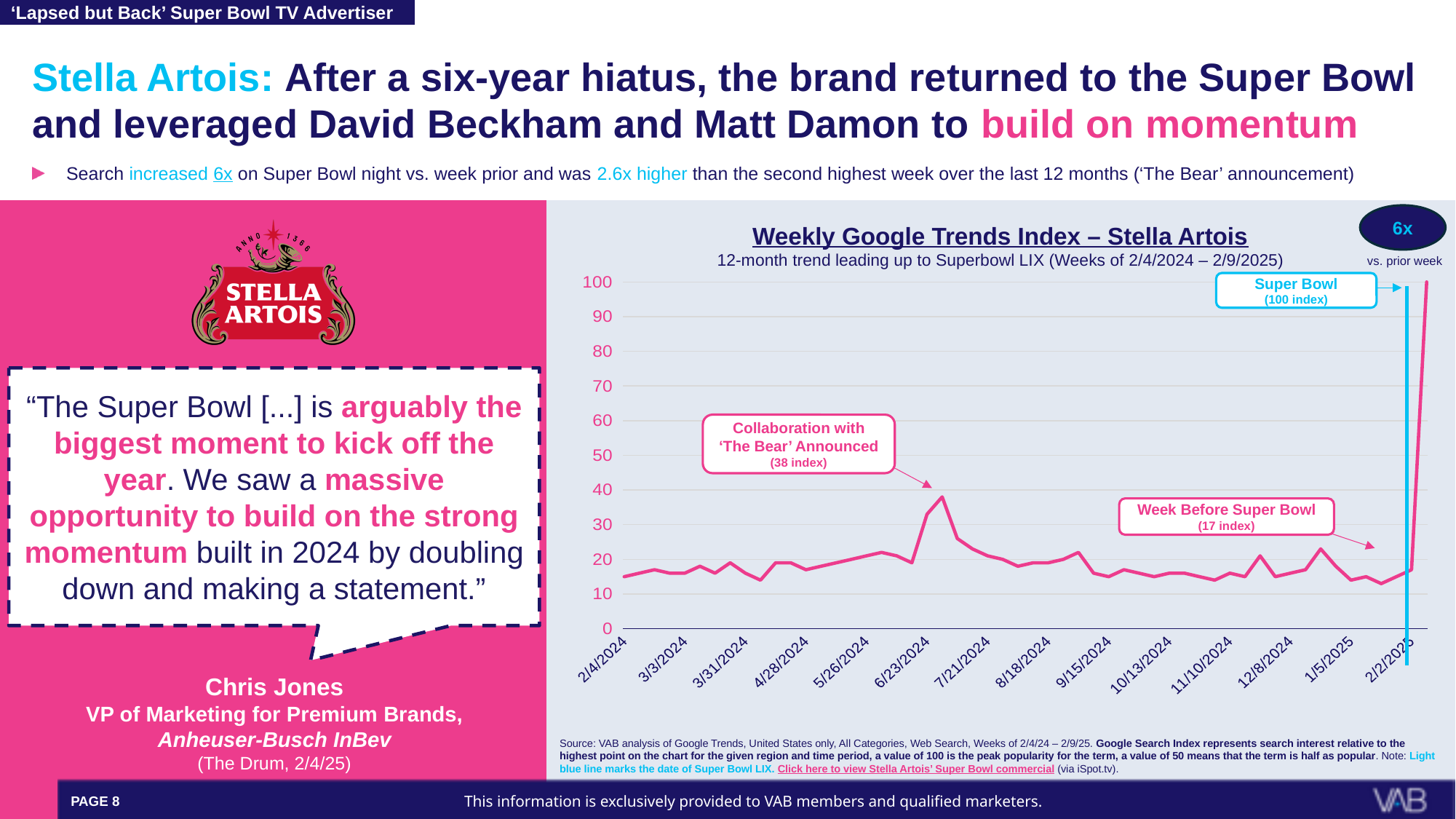
Which labeled event has the highest index value on the chart? Super Bowl Is the index value for the week of 10/13/2024 greater or less than 30? less Is the index value for the week of 2/4/2024 greater or less than 20? less What is the Google Trends index value for the Super Bowl week? 100 Which is larger: the index for the 'The Bear' announcement week or the index for the week before the Super Bowl? 'The Bear' announcement week How much higher is the Super Bowl index (100) than the 'The Bear' announcement index (38)? 62 What index value is labeled for the week when the collaboration with 'The Bear' was announced? 38 How many date labels are shown on the x axis? 14 What is the difference between the 'The Bear' announcement index and the week-before-Super-Bowl index? 21 What kind of chart is shown on the slide? Line chart What is the title of the chart? Weekly Google Trends Index – Stella Artois What index value is labeled for the week before the Super Bowl? 17